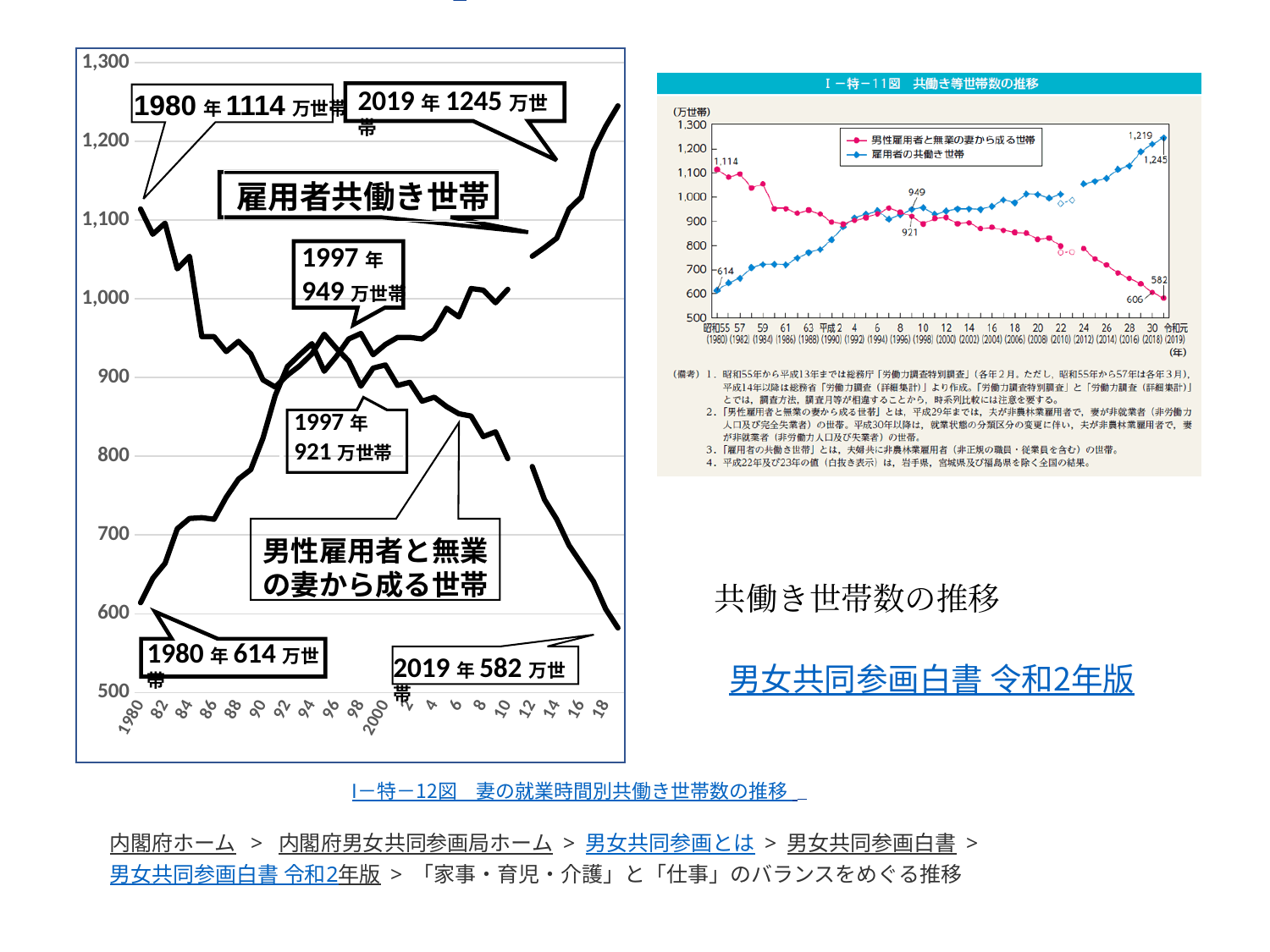
On the left chart, what is the value for 雇用者共働き世帯 in 1997? 949万世帯 What kind of chart is the large chart on the left of the slide? line chart On the left chart, what is the value for 男性雇用者と無業の妻から成る世帯 in 2019? 582万世帯 On the right chart (Ⅰ－特－11図), which series has the higher value in 2019 (令和元)? 雇用者の共働き世帯 On the left chart, what is the difference between the two series' values in 1997? 28万世帯 On the right chart (Ⅰ－特－11図), what value is labeled for 男性雇用者と無業の妻から成る世帯 in 2018 (平成30)? 606 On the left chart, is the value for 男性雇用者と無業の妻から成る世帯 in 2014 greater or less than 800? less On the right chart (Ⅰ－特－11図), how many series does the legend list? 2 On the left chart, what is the difference between the 2019 values of 雇用者共働き世帯 and 男性雇用者と無業の妻から成る世帯? 663万世帯 On the left chart, what is the difference between the 1980 values of 男性雇用者と無業の妻から成る世帯 and 雇用者共働き世帯? 500万世帯 On the left chart, does the 雇用者共働き世帯 line rise or fall from 1980 to 2019? rise On the left chart, what is the value for 雇用者共働き世帯 in 1980? 614万世帯